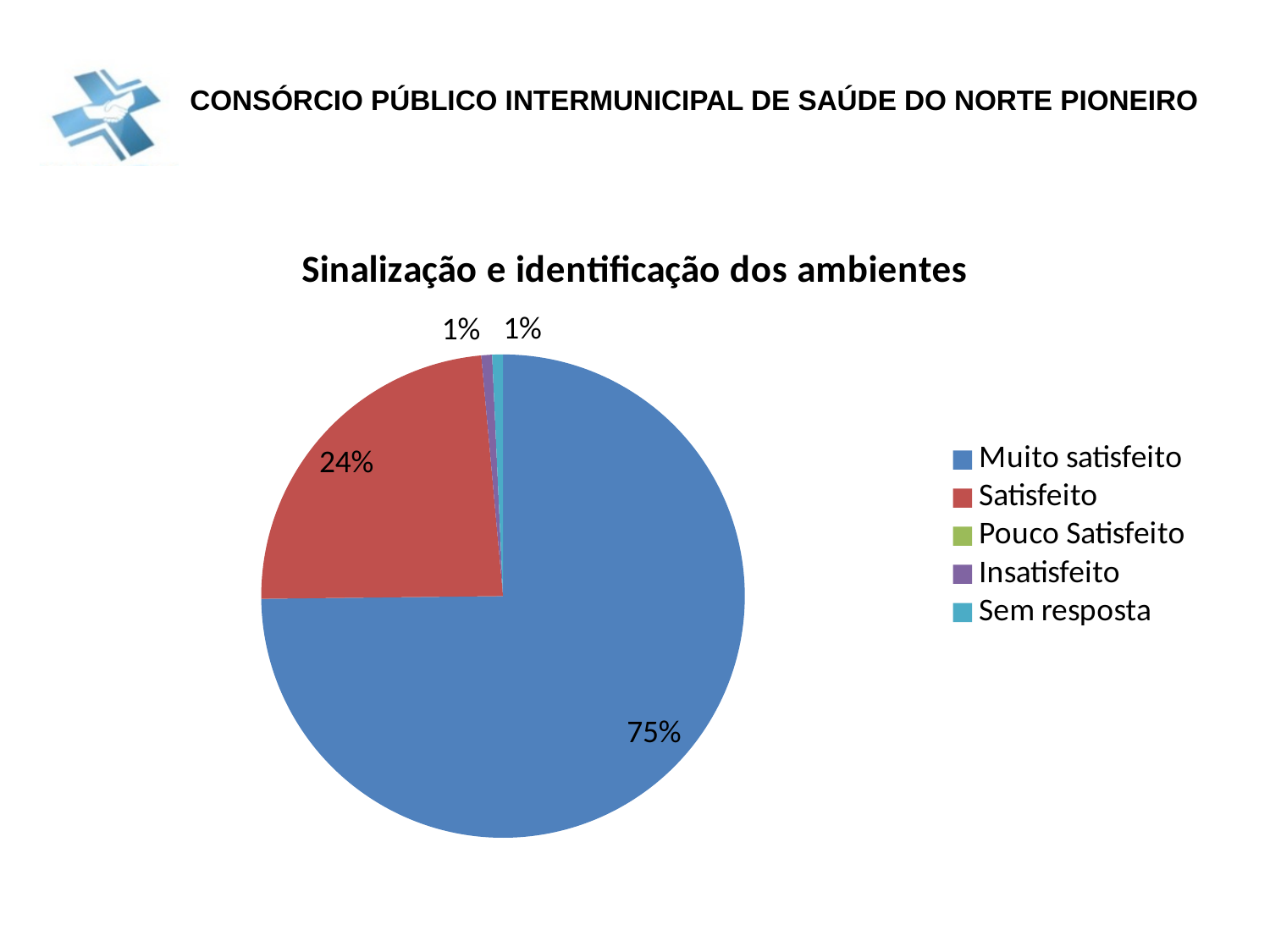
What percentage of the pie is labelled for Muito satisfeito? 75% What is the combined share of Muito satisfeito and Satisfeito? 99% Which slice is larger, Satisfeito or Muito satisfeito? Muito satisfeito How many entries does the legend list? 5 What colour is the Muito satisfeito slice? Blue What percentage is shown for the Satisfeito slice? 24% What is the title of the chart? Sinalização e identificação dos ambientes Which category has the largest slice of the pie? Muito satisfeito What percentage is shown for Sem resposta? 1% What is the difference in percentage points between Muito satisfeito and Satisfeito? 51 percentage points What percentage is shown for Insatisfeito? 1% What kind of chart is shown on the slide? Pie chart